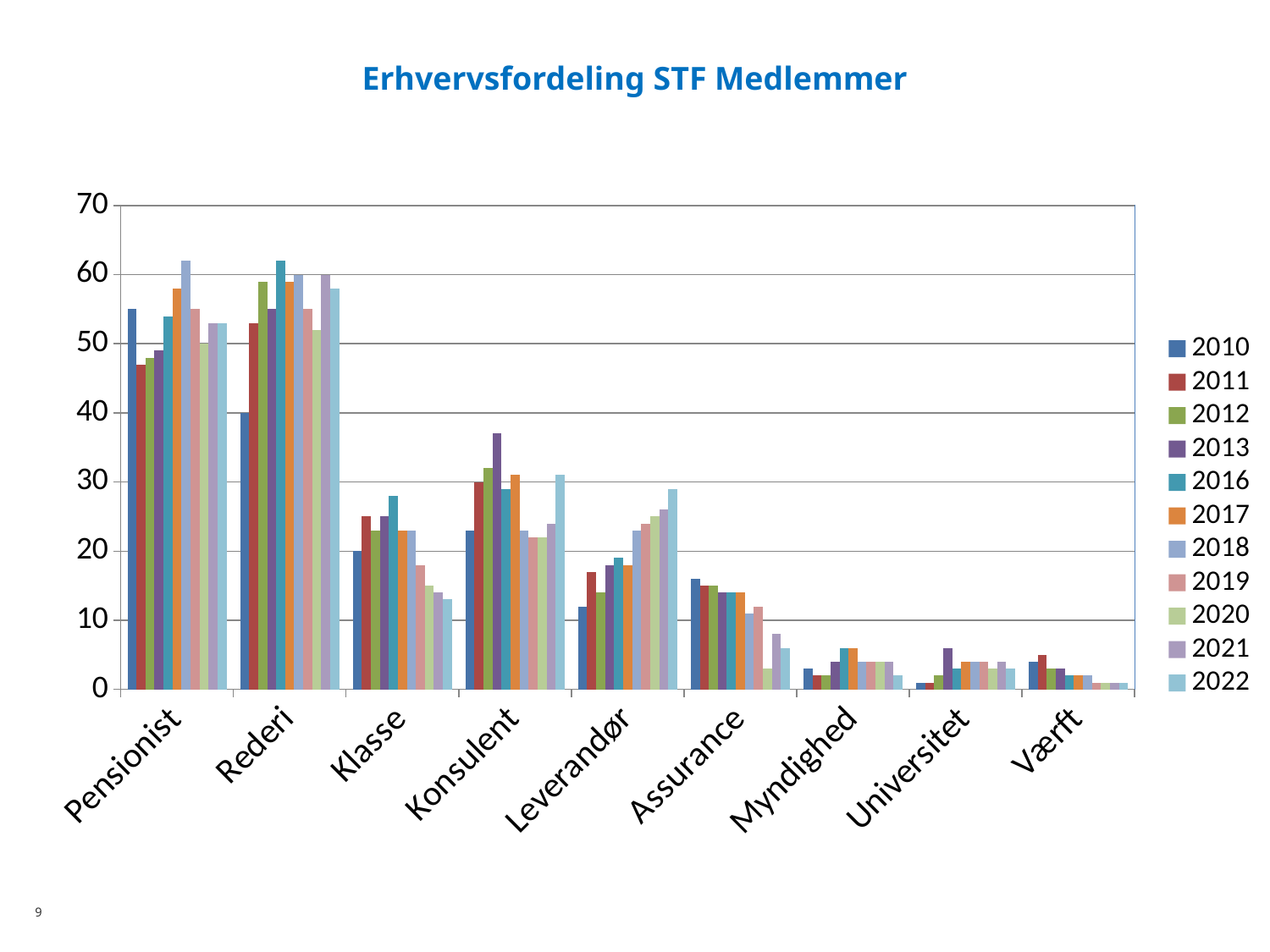
Which category has the highest value for 2010? Pensionist For the Assurance category, do the values generally rise or fall from 2010 to 2022? fall How many categories are shown on the x axis? 9 Is the value for Konsulent in 2013 greater or less than 30? greater Is the value for Assurance in 2020 greater or less than 10? less Which category has the highest value for 2022? Rederi Is the value for Klasse in 2022 greater or less than 20? less What is the title of the chart? Erhvervsfordeling STF Medlemmer Which is larger: the 2022 value for Leverandør or the 2022 value for Assurance? Leverandør How many series does the legend list? 11 Which is larger: the 2010 value for Pensionist or the 2010 value for Rederi? Pensionist What kind of chart is shown on the slide? bar chart